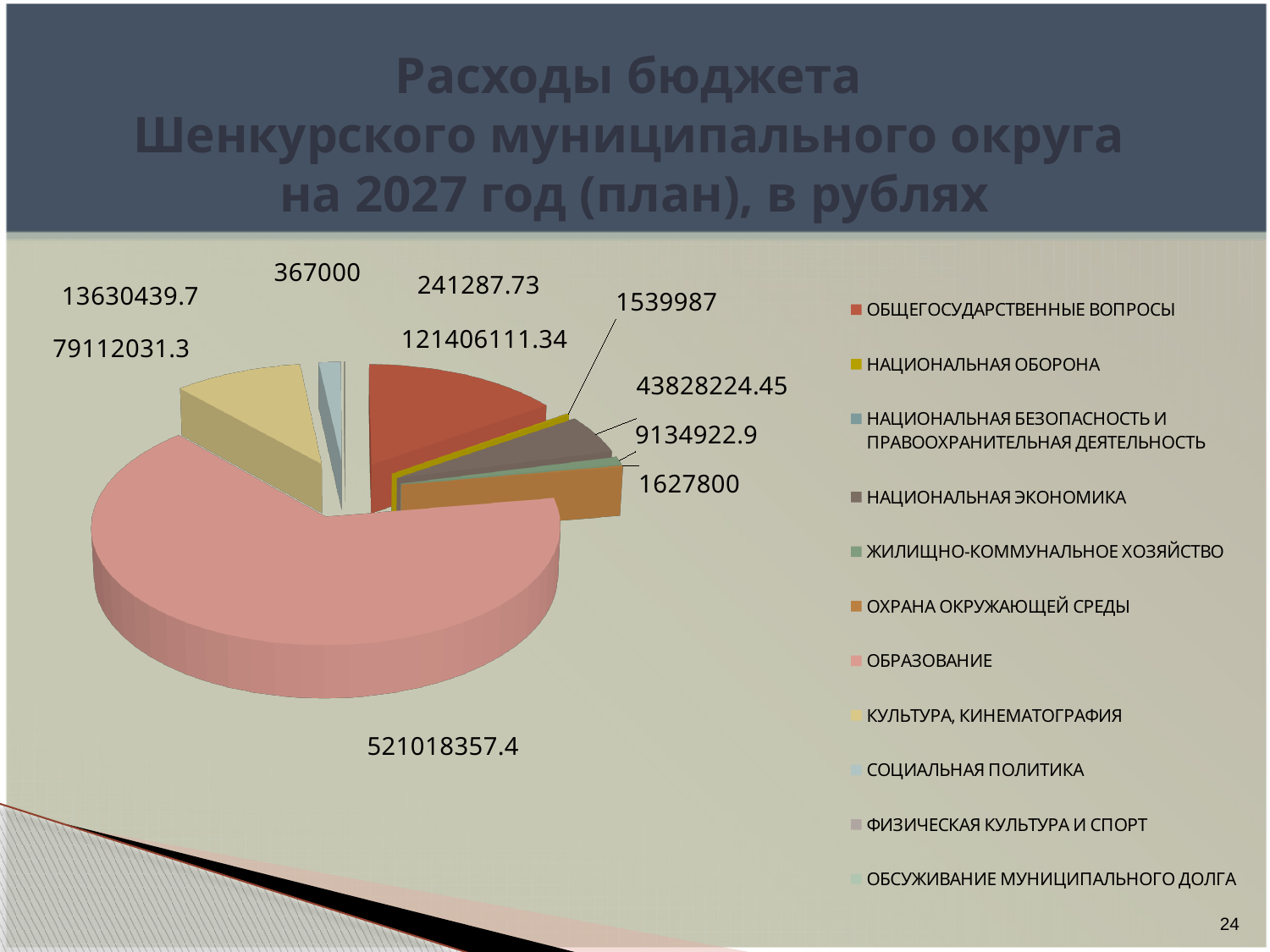
What type of chart is shown on the slide? pie chart What is the value for ОБРАЗОВАНИЕ in the pie chart? 521018357.4 What is the value for ОБЩЕГОСУДАРСТВЕННЫЕ ВОПРОСЫ in the pie chart? 121406111.34 What is the value of the largest slice in the pie chart? 521018357.4 What is the smallest value printed as a data label on the pie chart? 241287.73 What is the value for НАЦИОНАЛЬНАЯ ЭКОНОМИКА in the pie chart? 43828224.45 What is the value for КУЛЬТУРА, КИНЕМАТОГРАФИЯ in the pie chart? 79112031.3 Which category has the largest slice of the pie chart? ОБРАЗОВАНИЕ Which is larger in the pie chart: ОБРАЗОВАНИЕ or КУЛЬТУРА, КИНЕМАТОГРАФИЯ? ОБРАЗОВАНИЕ What is the title of the chart on the slide? Расходы бюджета Шенкурского муниципального округа на 2027 год (план), в рублях What is the difference between the values for ОБРАЗОВАНИЕ and КУЛЬТУРА, КИНЕМАТОГРАФИЯ? 441906326.1 How many categories does the legend of the pie chart list? 11